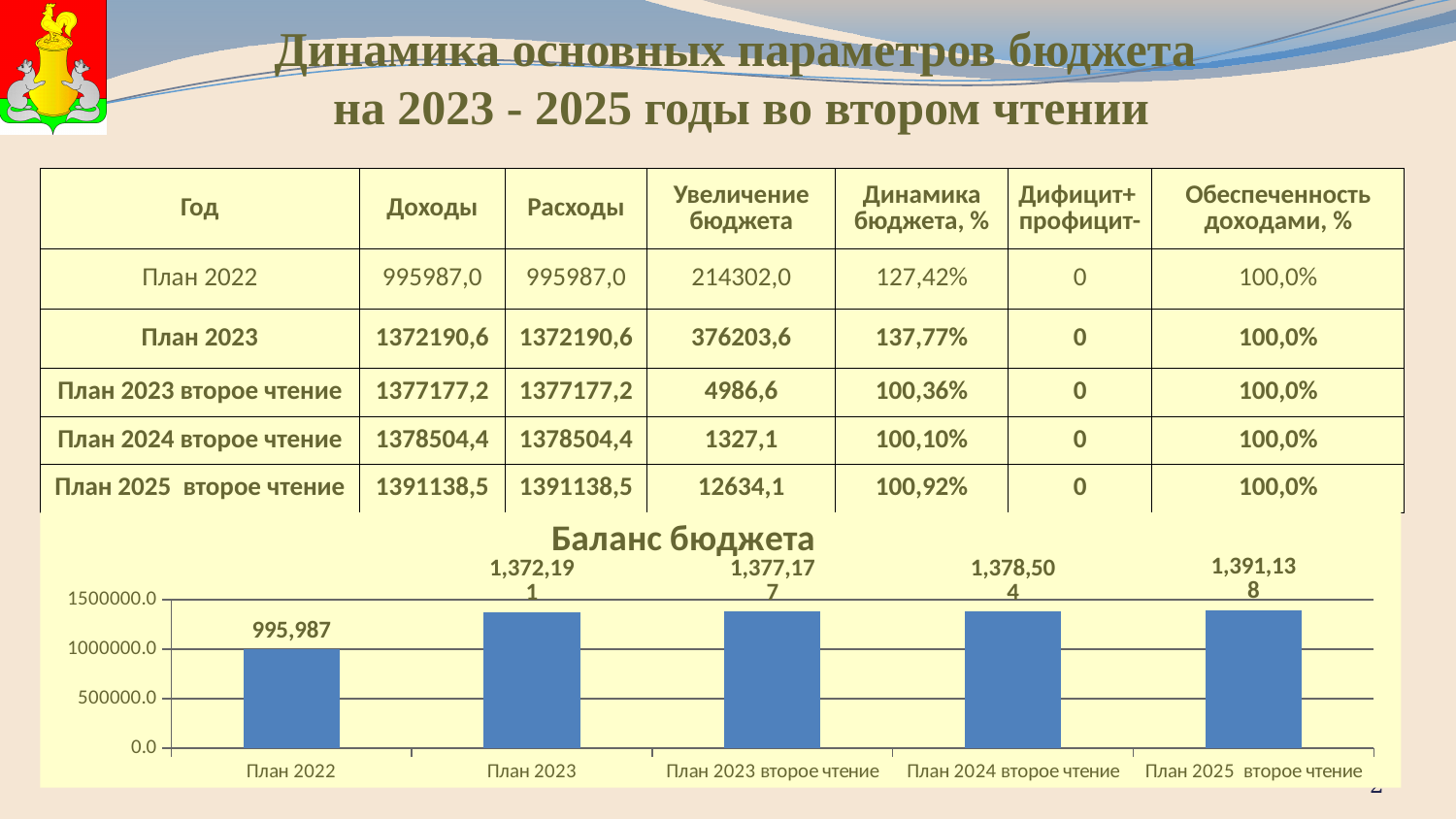
What type of chart is shown under the table? bar chart What is the value shown for План 2022 in the chart? 995,987 How many bars are plotted in the chart? 5 Is the value for План 2022 greater or less than 1000000.0? less What is the value shown for План 2024 второе чтение in the chart? 1,378,504 What is the title of the chart on the slide? Баланс бюджета Do the values in the chart rise or fall from left to right along the x axis? rise Which category has the highest value in the chart? План 2025 второе чтение Which category has the lowest value in the chart? План 2022 What is the value shown for План 2023 in the chart? 1,372,191 What is the difference between the values for План 2025 второе чтение and План 2024 второе чтение? 12,634 What is the value shown for План 2025 второе чтение in the chart? 1,391,138